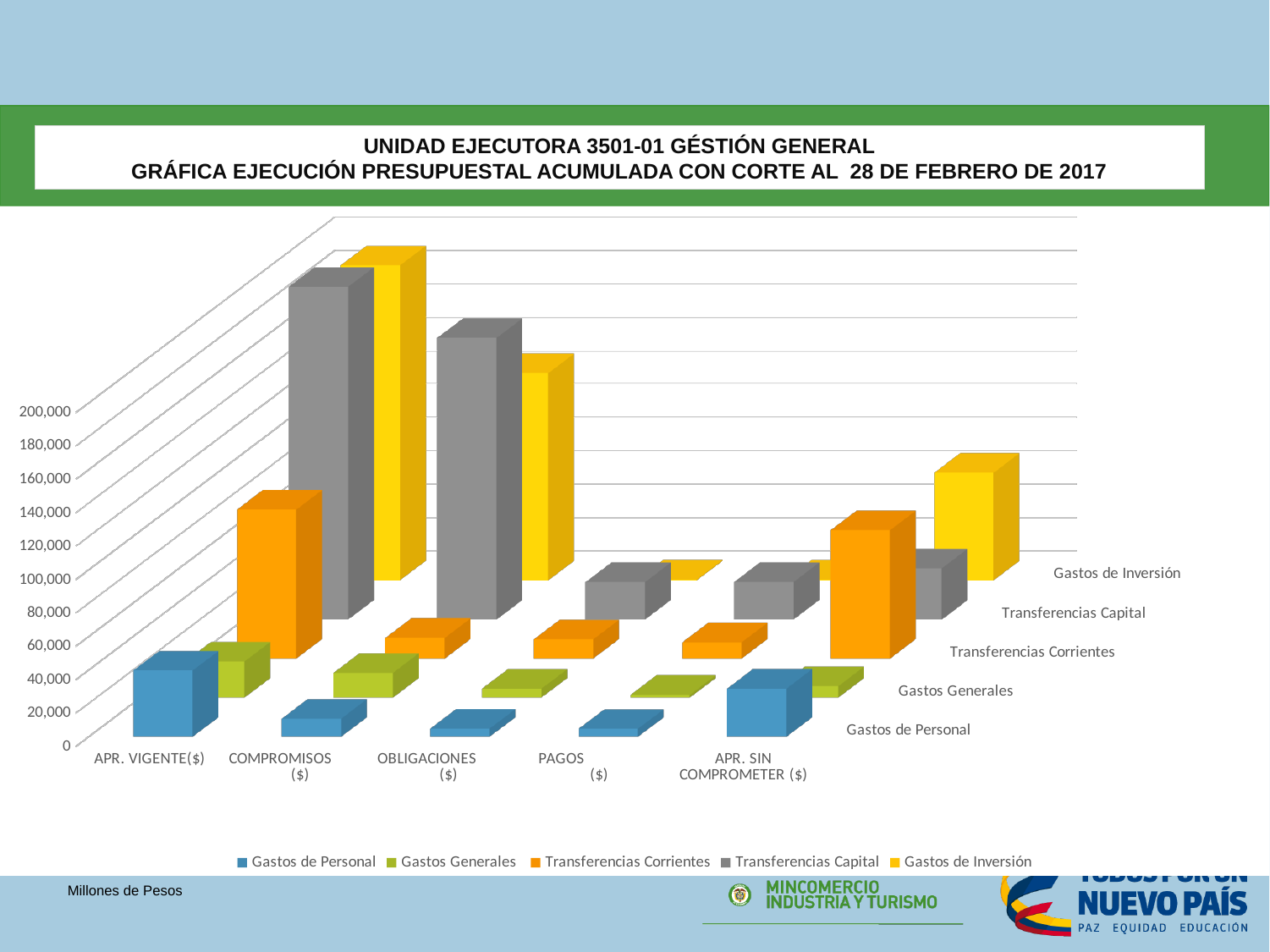
What kind of chart is shown on the slide? Bar chart What unit of measure is indicated for the chart's values? Millones de Pesos How many categories are shown along the x axis of the chart? 5 Which series is shown in yellow in the chart? Gastos de Inversión Which is larger, the Transferencias Capital value for APR. VIGENTE($) or for PAGOS ($)? APR. VIGENTE($) Do the Transferencias Capital values rise or fall from APR. VIGENTE($) to PAGOS ($)? fall Is the Gastos de Personal value for APR. SIN COMPROMETER ($) greater or less than 60,000? less Is the Gastos de Personal value for APR. VIGENTE($) greater or less than 60,000? less Is the Gastos de Personal value for COMPROMISOS ($) greater or less than 40,000? less Which is larger, the Gastos de Inversión value for APR. VIGENTE($) or for APR. SIN COMPROMETER ($)? APR. VIGENTE($) How many series does the chart's legend list? 5